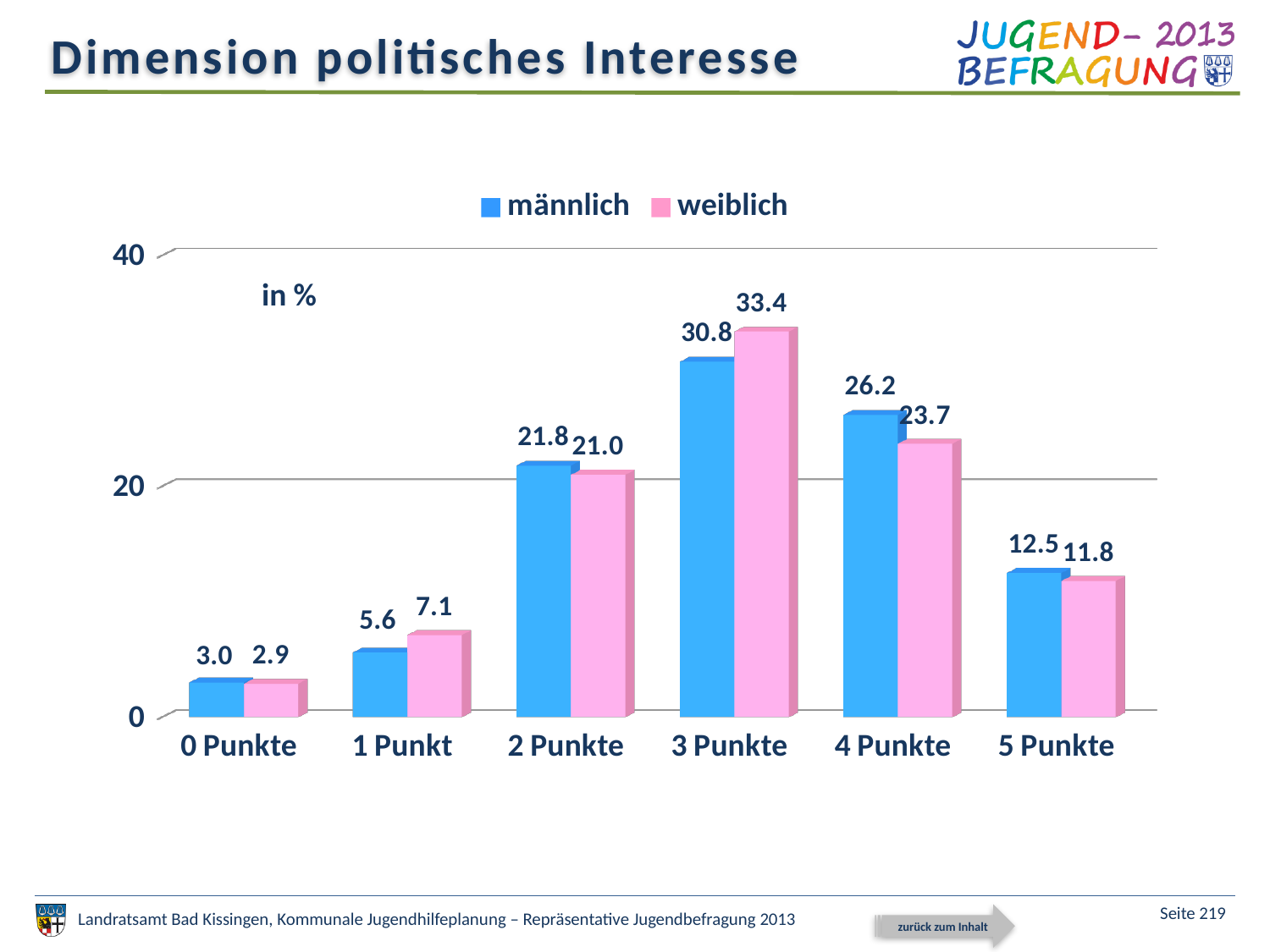
How many categories are shown on the x axis? 6 Which category has the lowest value for männlich? 0 Punkte Which category has the highest value for weiblich? 3 Punkte How many series does the legend list? 2 What is the value for männlich at 3 Punkte? 30.8 What unit is indicated on the chart? in % What kind of chart is shown on the slide? bar chart What is the value for weiblich at 4 Punkte? 23.7 Is the value for weiblich at 3 Punkte greater or less than 20? greater Which is larger at 2 Punkte, männlich or weiblich? männlich What is the value for weiblich at 1 Punkt? 7.1 What is the difference between männlich and weiblich at 4 Punkte? 2.5